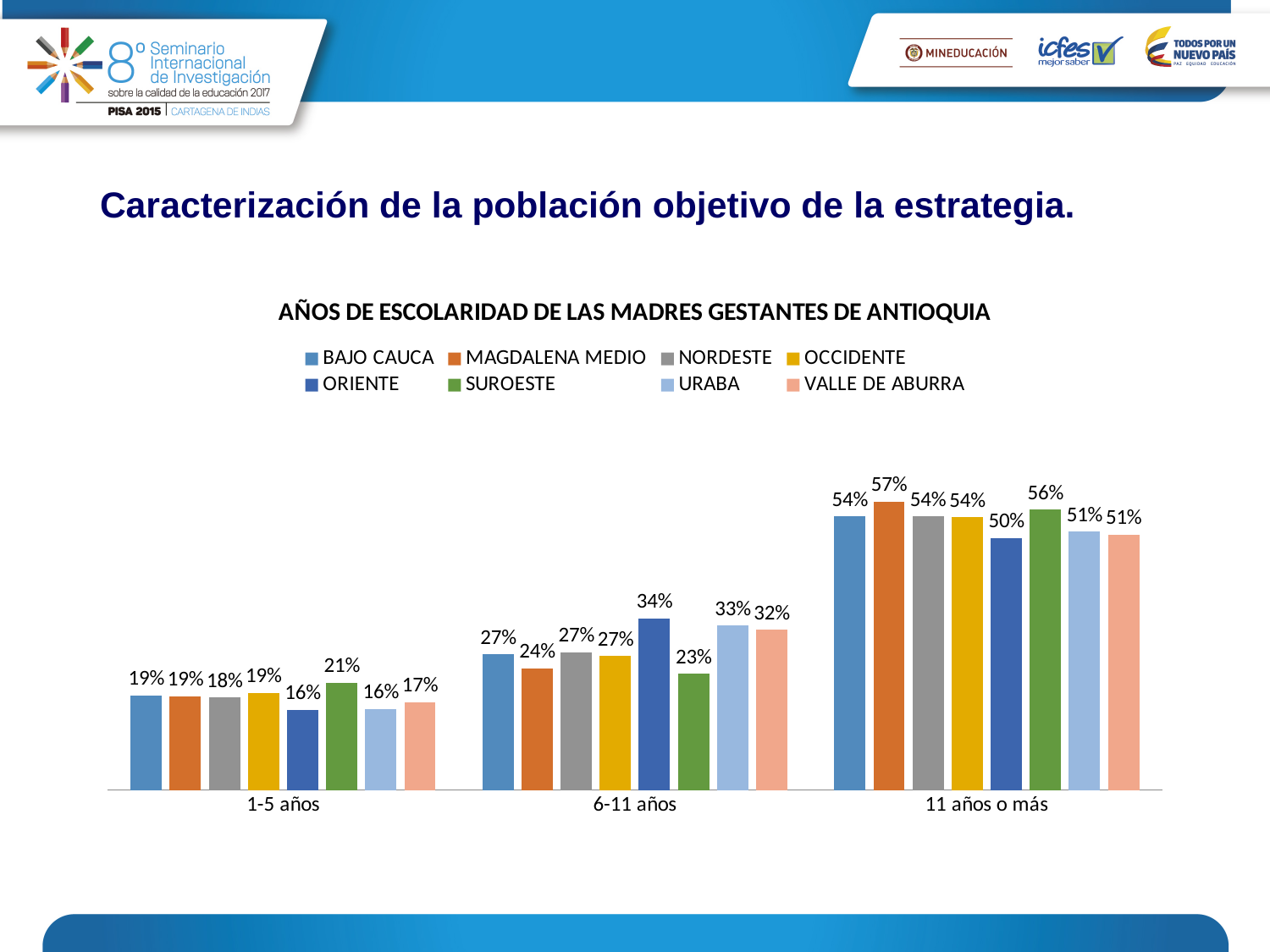
What is the value for MAGDALENA MEDIO in the 11 años o más category? 57% How many series does the legend list? 8 Which region has the lowest value in the 6-11 años category? SUROESTE Which region has the highest value in the 6-11 años category? ORIENTE What is the value for SUROESTE in the 1-5 años category? 21% What is the title of the chart? AÑOS DE ESCOLARIDAD DE LAS MADRES GESTANTES DE ANTIOQUIA In the 11 años o más category, which is larger: the value for SUROESTE or the value for ORIENTE? SUROESTE What kind of chart is shown on the slide? Bar chart What is the value for ORIENTE in the 6-11 años category? 34% How many categories are shown on the x axis? 3 What is the difference between the ORIENTE and SUROESTE values in the 6-11 años category? 11% Which region has the highest value in the 11 años o más category? MAGDALENA MEDIO